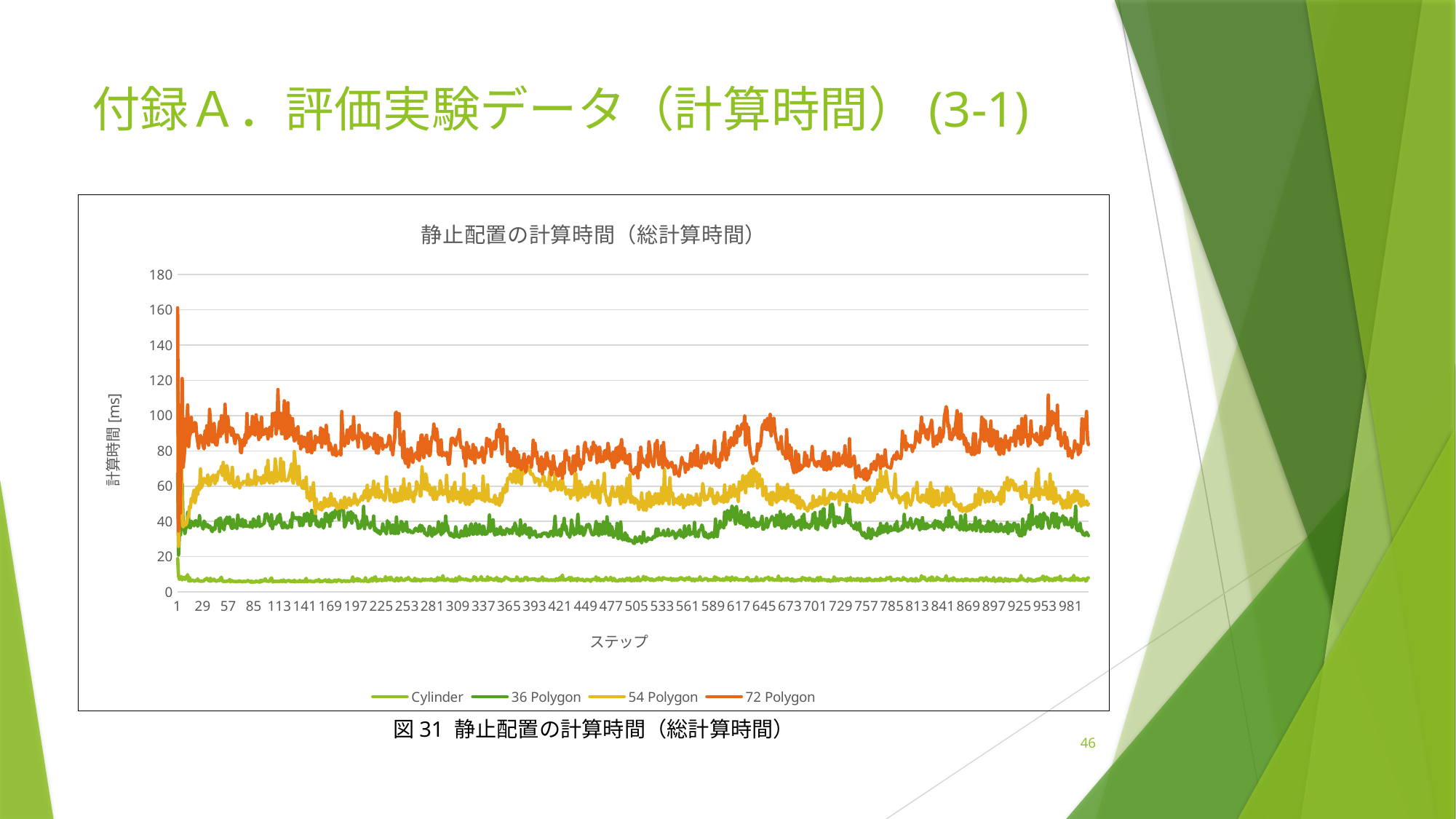
Which series in the chart has the highest computation time across the steps? 72 Polygon What is the maximum value shown on the vertical axis of the chart? 180 Is the value for 36 Polygon at step 281 greater or less than 60? less What is the title of the chart? 静止配置の計算時間（総計算時間） Is the value for 72 Polygon at step 505 greater or less than 60? greater What kind of chart is shown on the slide? line chart Which series in the chart has the lowest computation time across the steps? Cylinder How many series does the legend of the chart list? 4 What is the label of the vertical axis of the chart? 計算時間 [ms] Is the value for Cylinder at step 505 greater or less than 20? less Which series has larger values over most of the steps, 36 Polygon or 54 Polygon? 54 Polygon